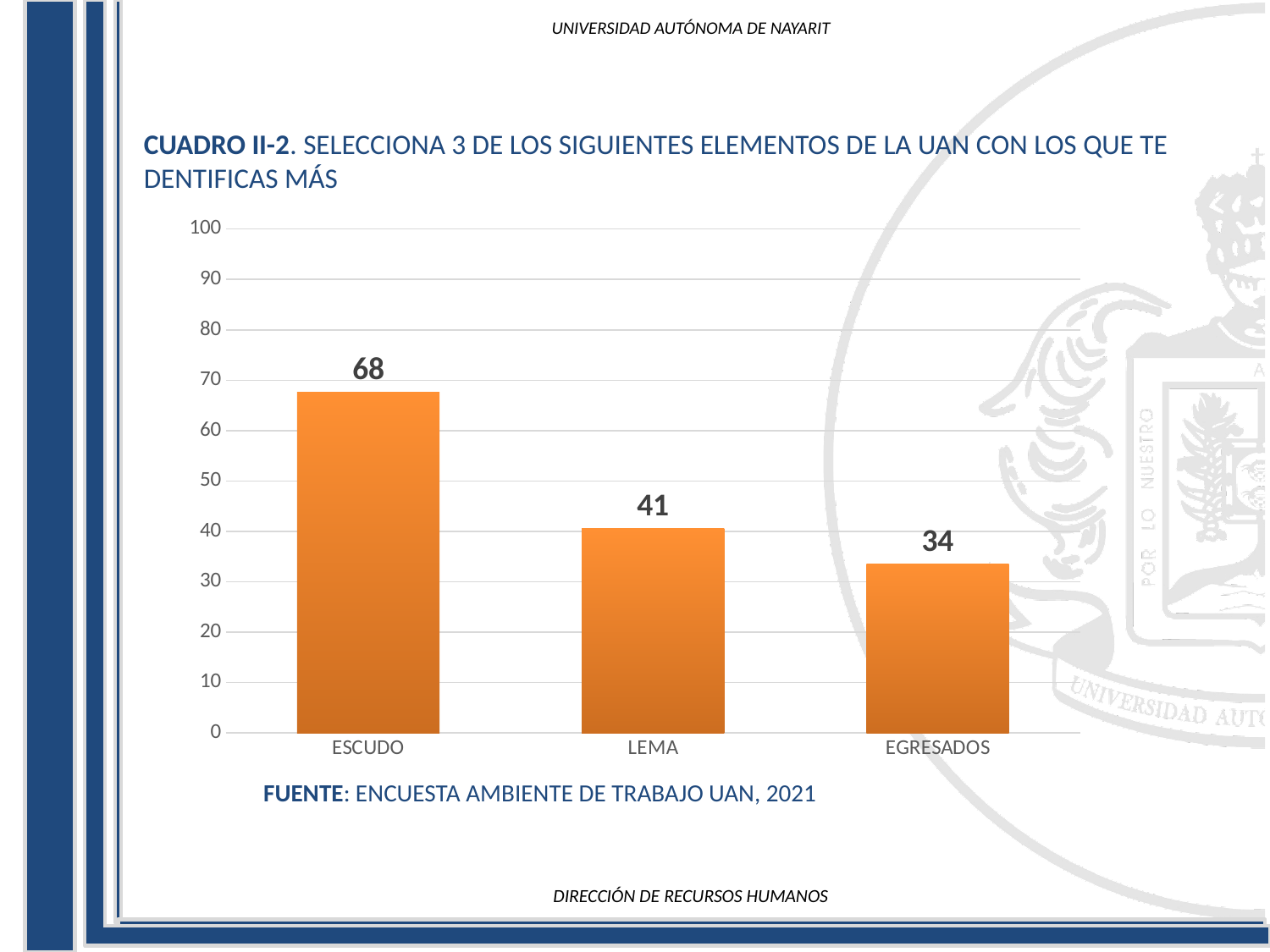
What kind of chart is shown on the slide? bar chart Which is larger, the value for LEMA or the value for EGRESADOS? LEMA Which category has the highest value? ESCUDO Do the values rise or fall from left to right along the x axis? fall What is the difference between the values for LEMA and EGRESADOS? 7 Is the value for ESCUDO greater or less than 60? greater How many categories are shown on the x axis? 3 What is the value for LEMA? 41 Which category has the lowest value? EGRESADOS What is the difference between the values for ESCUDO and LEMA? 27 What is the value for EGRESADOS? 34 What is the value for ESCUDO? 68